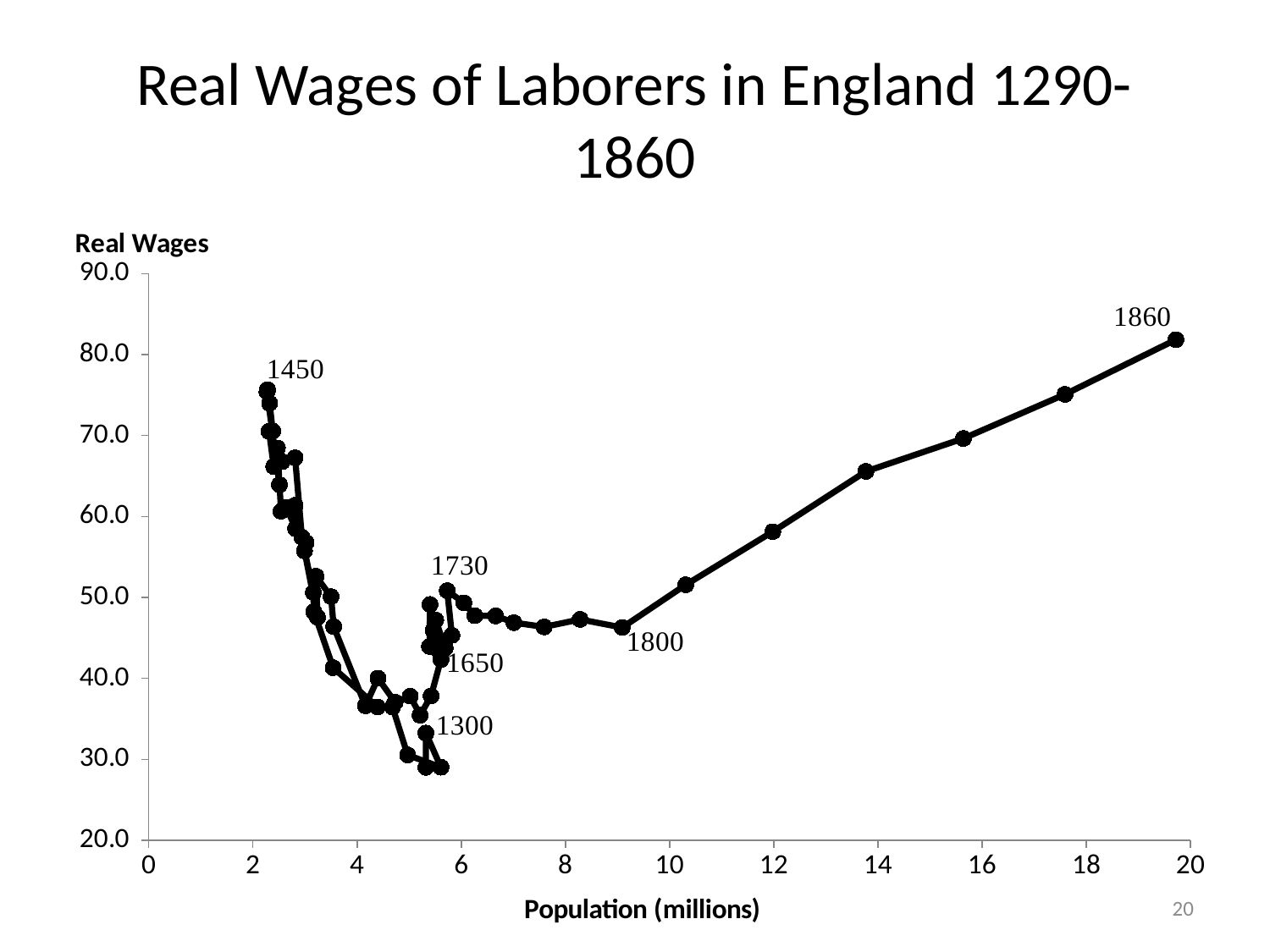
Is the population at the point labeled 1860 greater or less than 18 million? greater What kind of chart is shown on the slide? line chart Is the real wage at the point labeled 1860 greater or less than 70? greater Is the real wage at the point labeled 1300 greater or less than 40? less Of the years labeled on the chart, which has the lowest real wage? 1300 Between the points labeled 1800 and 1860, do real wages rise or fall as population increases? rise Which labeled year has the higher real wage, 1300 or 1800? 1800 What is the label of the horizontal axis? Population (millions) What is the title of the chart? Real Wages of Laborers in England 1290-1860 Which labeled year has the higher real wage, 1860 or 1450? 1860